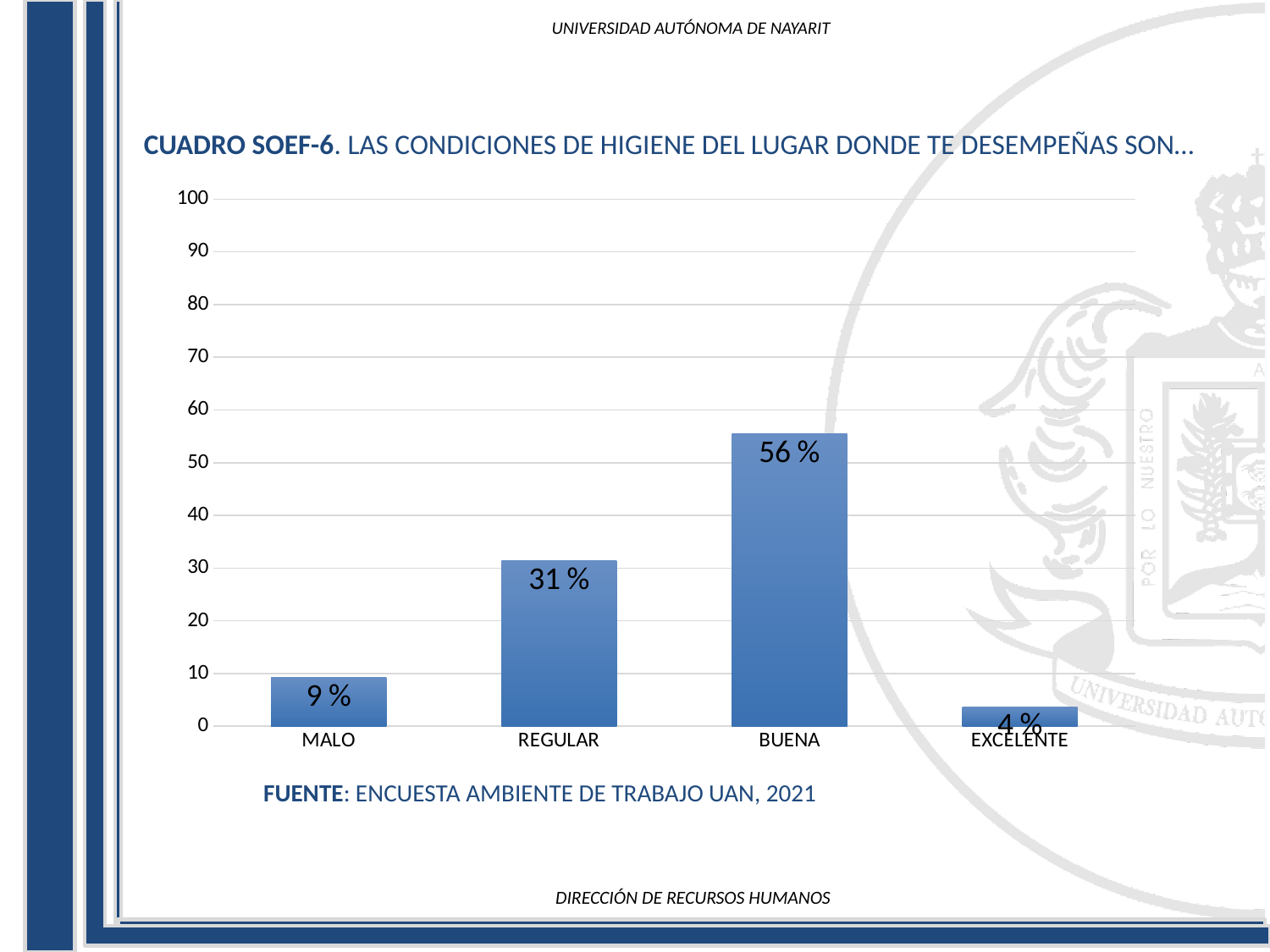
Which category has the lowest value? EXCELENTE What is the value for BUENA? 56 % Is the value for REGULAR greater or less than 40? less What kind of chart is shown on the slide? bar chart What source is cited below the chart? ENCUESTA AMBIENTE DE TRABAJO UAN, 2021 Which is larger, the value for MALO or the value for EXCELENTE? MALO What is the value for EXCELENTE? 4 % How many categories are shown on the x axis? 4 What is the value for REGULAR? 31 % Which category has the highest value? BUENA What is the difference between the values for BUENA and REGULAR? 25 % What is the value for MALO? 9 %